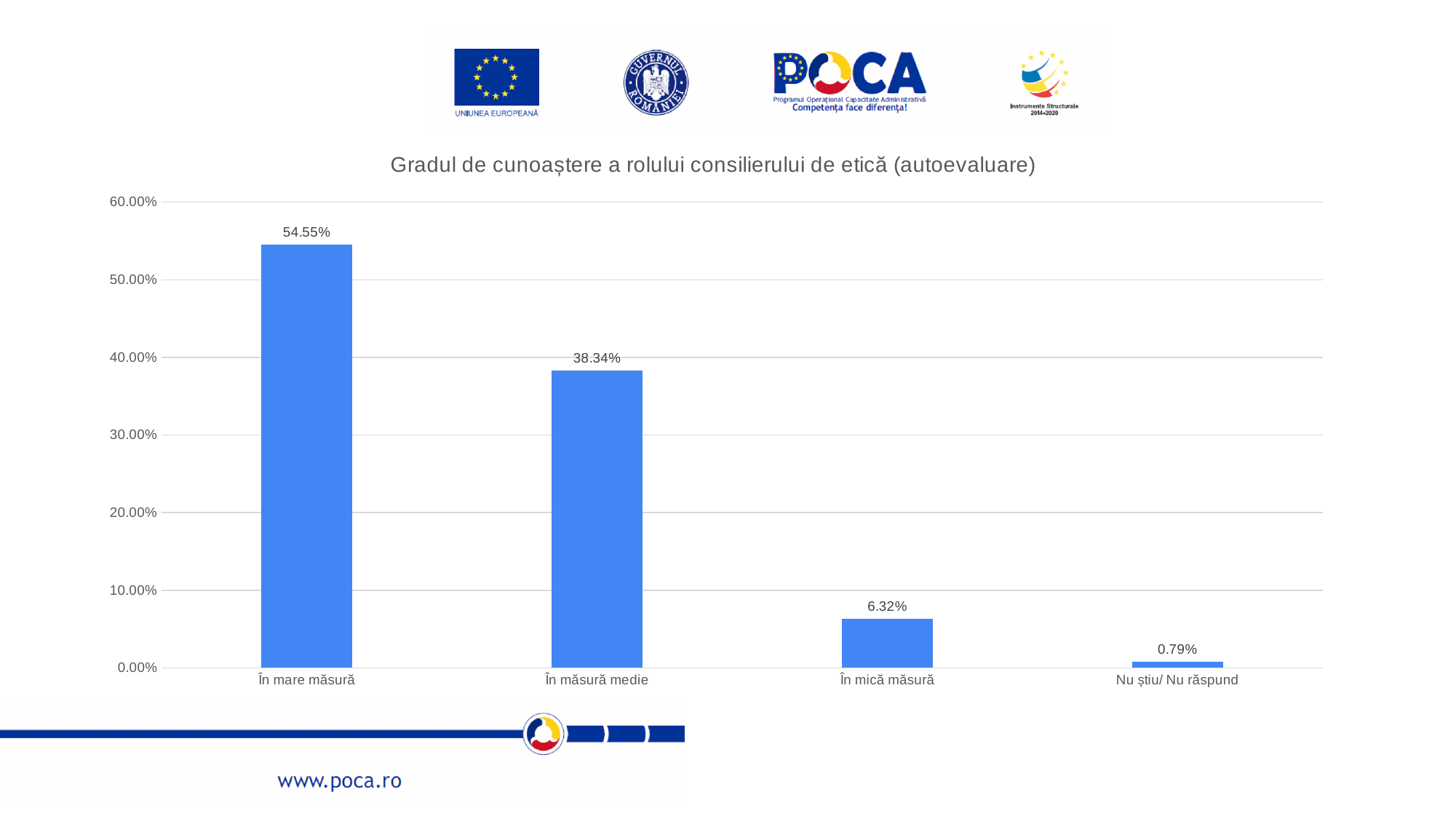
Which is larger, the value for 'În mică măsură' or the value for 'Nu știu/ Nu răspund'? În mică măsură What is the value for 'Nu știu/ Nu răspund'? 0.79% How many categories are shown on the x axis? 4 What is the value for 'În mare măsură'? 54.55% What is the value for 'În măsură medie'? 38.34% Which category has the highest value? În mare măsură What is the value for 'În mică măsură'? 6.32% What kind of chart is shown on the slide? bar chart Which category has the lowest value? Nu știu/ Nu răspund What is the title of the chart? Gradul de cunoaștere a rolului consilierului de etică (autoevaluare) What is the difference between the values for 'În mare măsură' and 'În măsură medie'? 16.21% Is the value for 'În măsură medie' greater or less than 40.00%? less